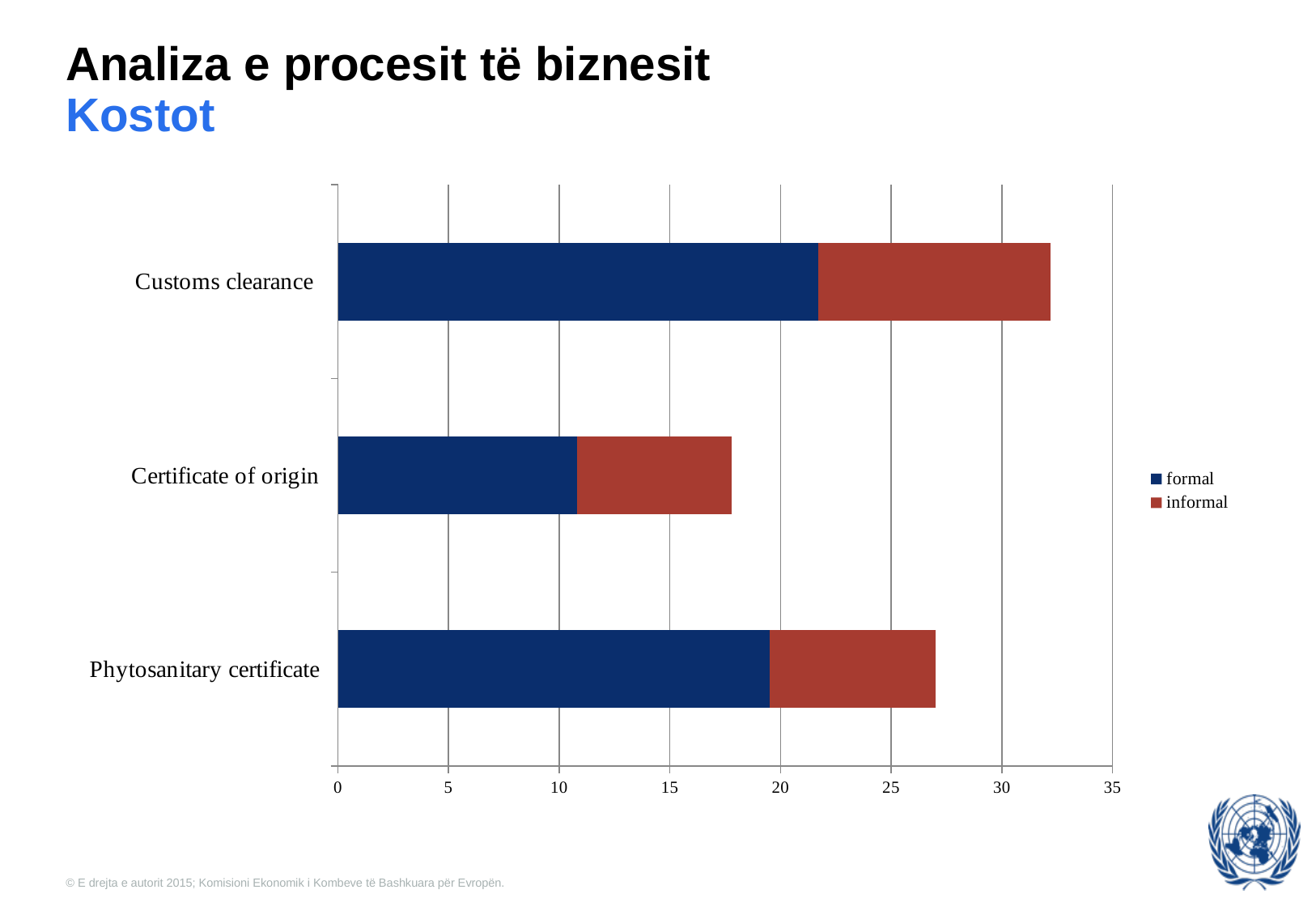
Which category has the largest formal value? Customs clearance How many categories are shown on the chart? 3 Is the total bar for Phytosanitary certificate greater or less than 25? greater Which series is shown in dark blue in the legend? formal Is the total bar for Customs clearance greater or less than 30? greater Is the formal value for Customs clearance greater or less than 20? greater Which category has the longest total bar? Customs clearance Which is larger, the formal value for Phytosanitary certificate or the formal value for Certificate of origin? Phytosanitary certificate How many series does the legend list? 2 Which category has the shortest total bar? Certificate of origin What kind of chart is shown on the slide? stacked bar chart